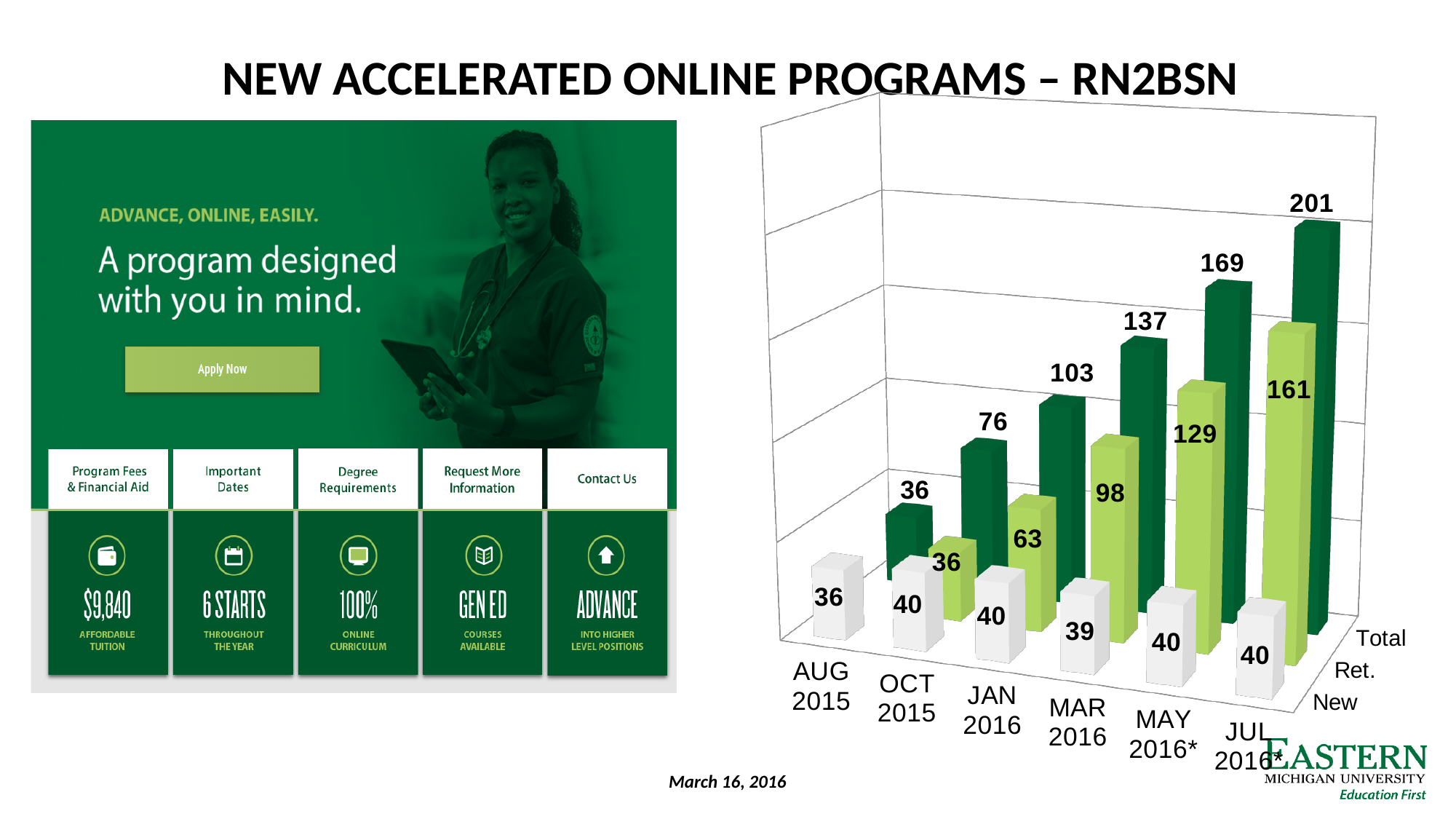
What is the difference between the Total values for JUL 2016* and MAY 2016*? 32 What is the Total value for JAN 2016? 103 Which period has the lowest New value? AUG 2015 How many periods are shown on the x axis of the chart? 6 What is the Ret. value for MAR 2016? 98 Which is larger, the Ret. value for MAY 2016* or the Total value for JAN 2016? Ret. value for MAY 2016* What is the New value for AUG 2015? 36 What kind of chart is shown on the slide? Bar chart Do the Total values rise or fall from AUG 2015 to JUL 2016*? Rise Which period has the highest Total value? JUL 2016* How many series does the chart show? 3 What is the Total value for JUL 2016*? 201